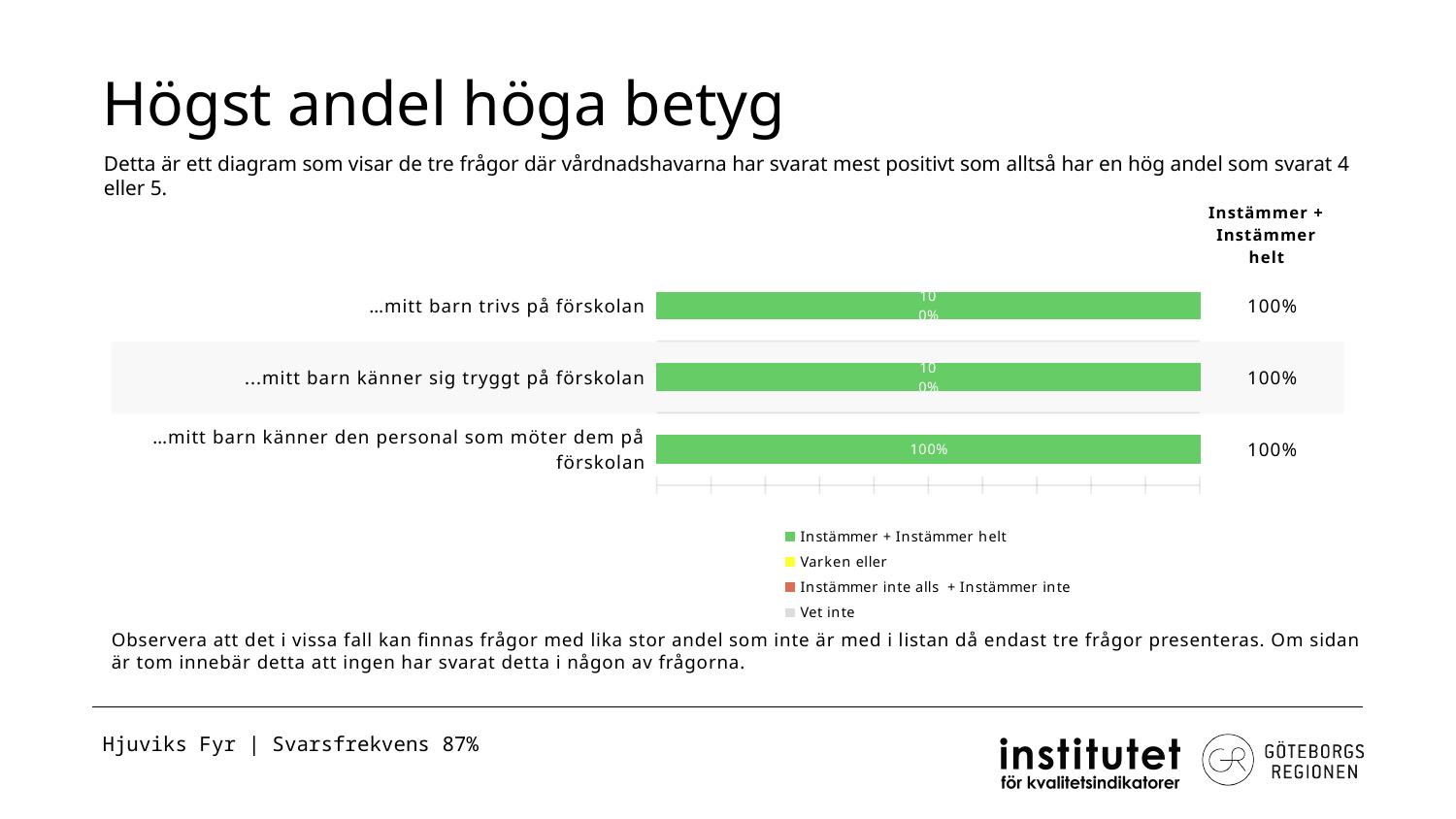
What is the heading of the column of values to the right of the bars? Instämmer + Instämmer helt What colour are the bars in the chart? green How many series does the legend list? 4 What is the 'Instämmer + Instämmer helt' value shown for '…mitt barn känner den personal som möter dem på förskolan'? 100% What is the difference between the 'Instämmer + Instämmer helt' values for '…mitt barn trivs på förskolan' and '…mitt barn känner sig tryggt på förskolan'? 0% What is the 'Instämmer + Instämmer helt' value shown for '…mitt barn trivs på förskolan'? 100% What is the first entry listed in the chart legend? Instämmer + Instämmer helt What kind of chart is shown on the slide? bar chart What is the 'Instämmer + Instämmer helt' value shown for '…mitt barn känner sig tryggt på förskolan'? 100% How many categories (questions) are plotted in the chart? 3